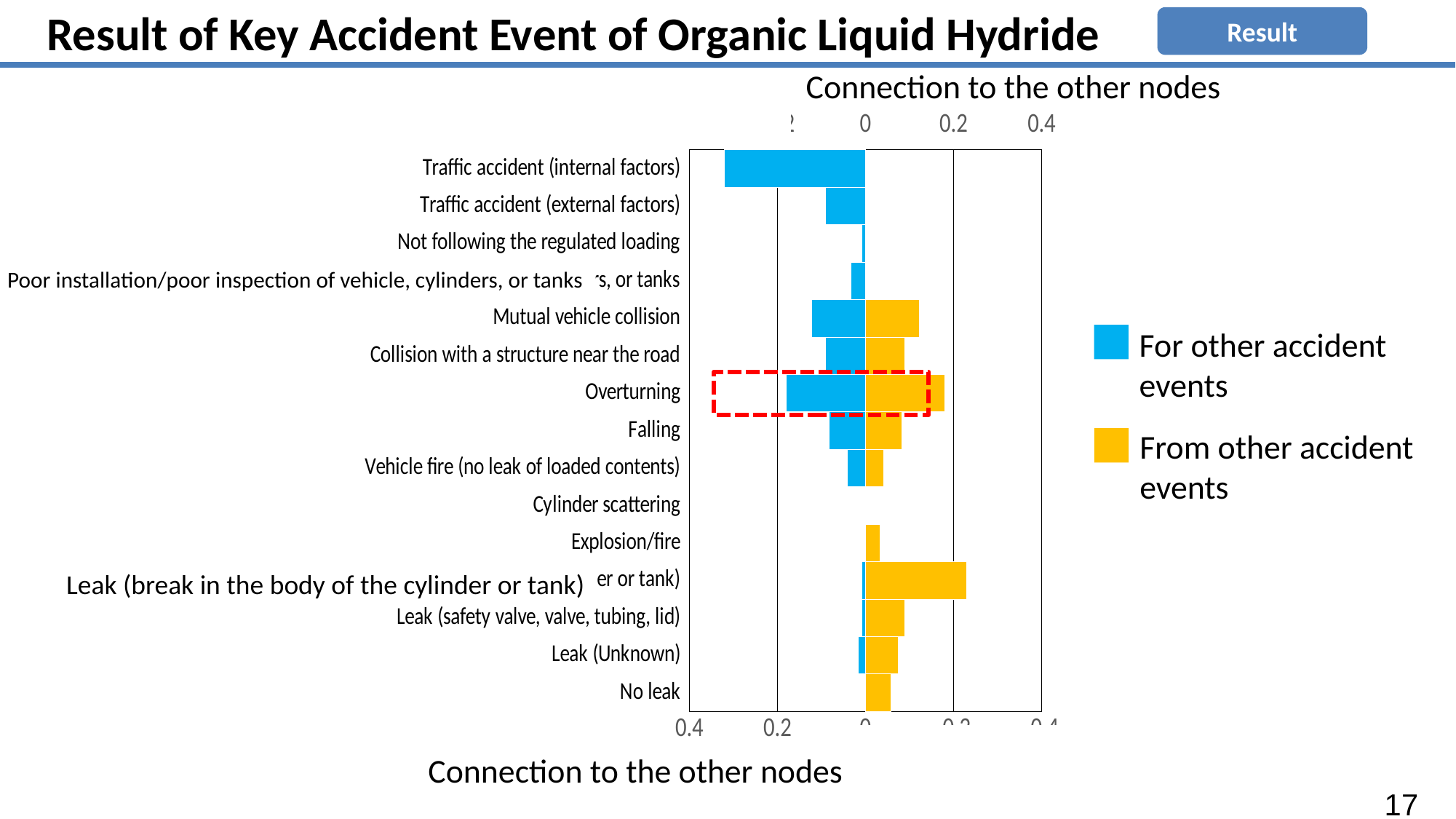
Which has the larger 'From other accident events' value: Mutual vehicle collision or Explosion/fire? Mutual vehicle collision Which has the larger 'For other accident events' value: Traffic accident (internal factors) or Traffic accident (external factors)? Traffic accident (internal factors) Is the 'For other accident events' value for Traffic accident (external factors) greater or less than 0.2? less Which category has the longest bar for the 'For other accident events' series? Traffic accident (internal factors) Is the 'For other accident events' value for Traffic accident (internal factors) greater or less than 0.2? greater Which category is highlighted with a red dashed box on the chart? Overturning What colour represents the 'From other accident events' series? yellow What kind of chart is shown on the slide? bar chart Which category has the longest bar for the 'From other accident events' series? Leak (break in the body of the cylinder or tank) Is the 'From other accident events' value for Mutual vehicle collision greater or less than 0.2? less How many accident event categories are plotted on the chart? 15 How many series does the legend list? 2